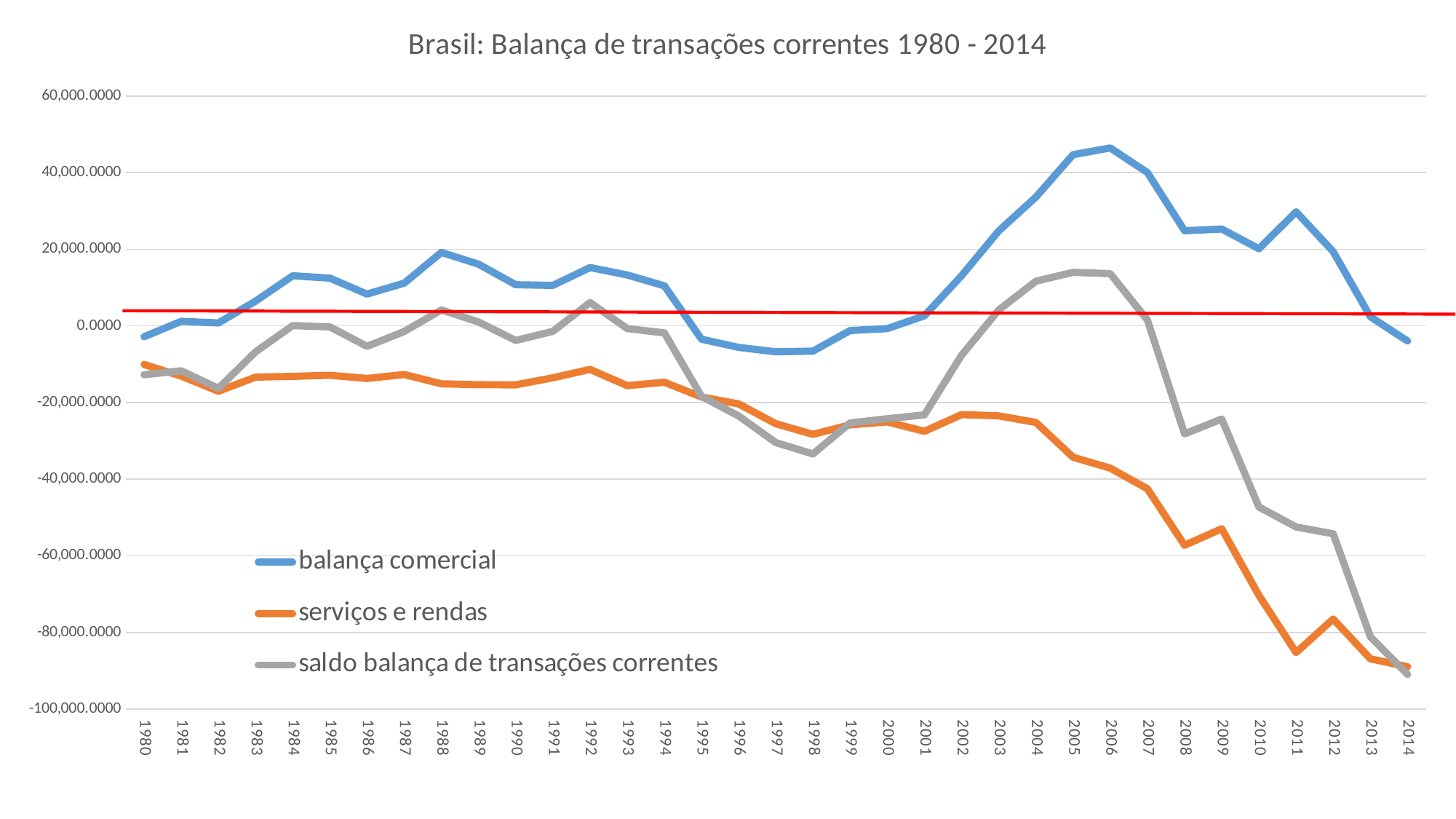
Is the value for serviços e rendas in 2011 greater or less than -80,000? less How many years are plotted along the x axis? 35 How many series does the legend list? 3 Is the value for balança comercial in 1998 greater or less than 0? less Is the value for balança comercial in 2006 greater or less than 40,000? greater Does the saldo balança de transações correntes series rise or fall from 2007 to 2014? fall What is the title of the chart? Brasil: Balança de transações correntes 1980 - 2014 What kind of chart is shown on the slide? line chart In which year does the saldo balança de transações correntes series reach its lowest value? 2014 What colour is the serviços e rendas line? orange In which year does the balança comercial series reach its highest value? 2006 In 2014, which series has the higher value: balança comercial or serviços e rendas? balança comercial